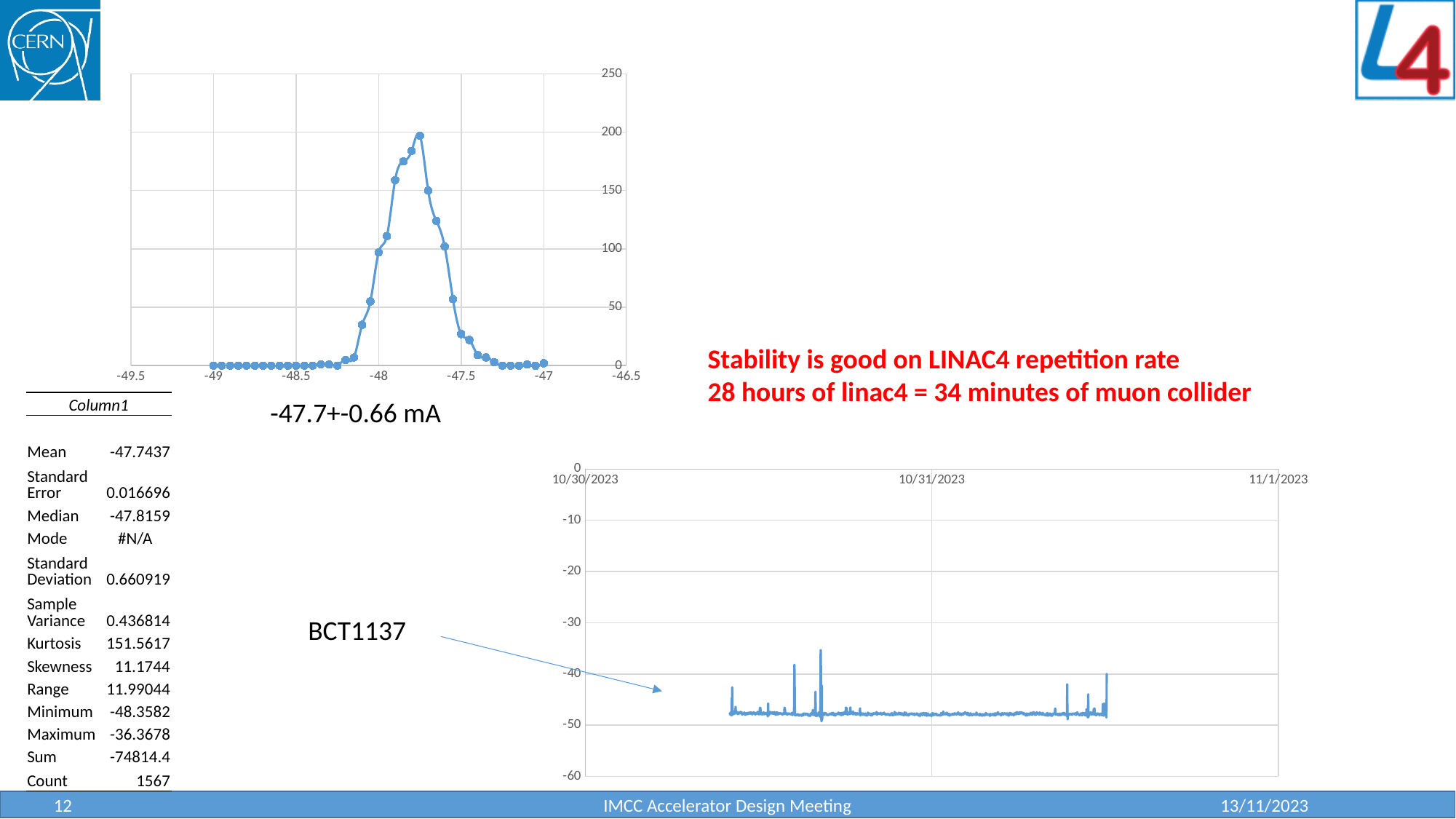
In the bottom-right chart, is the tallest spike greater or less than -40? greater What kind of chart is the bottom-right chart on the slide? line chart In the bottom-right chart, what is the lowest value shown on the vertical axis? -60 What kind of chart is the top-left chart on the slide? line chart In the bottom-right chart, is the baseline level of the trace greater or less than -40? less In the top-left chart, is the peak value greater or less than 150? greater In the top-left chart, do the values rise or fall as x goes from -47.75 to -47.5? fall How many date labels are shown on the horizontal axis of the bottom-right chart? 3 In the top-left chart, what is the highest value shown on the vertical axis? 250 In the top-left chart, what is the value at x = -49? 0 In the top-left chart, do the values rise or fall as x goes from -48 to -47.75? rise